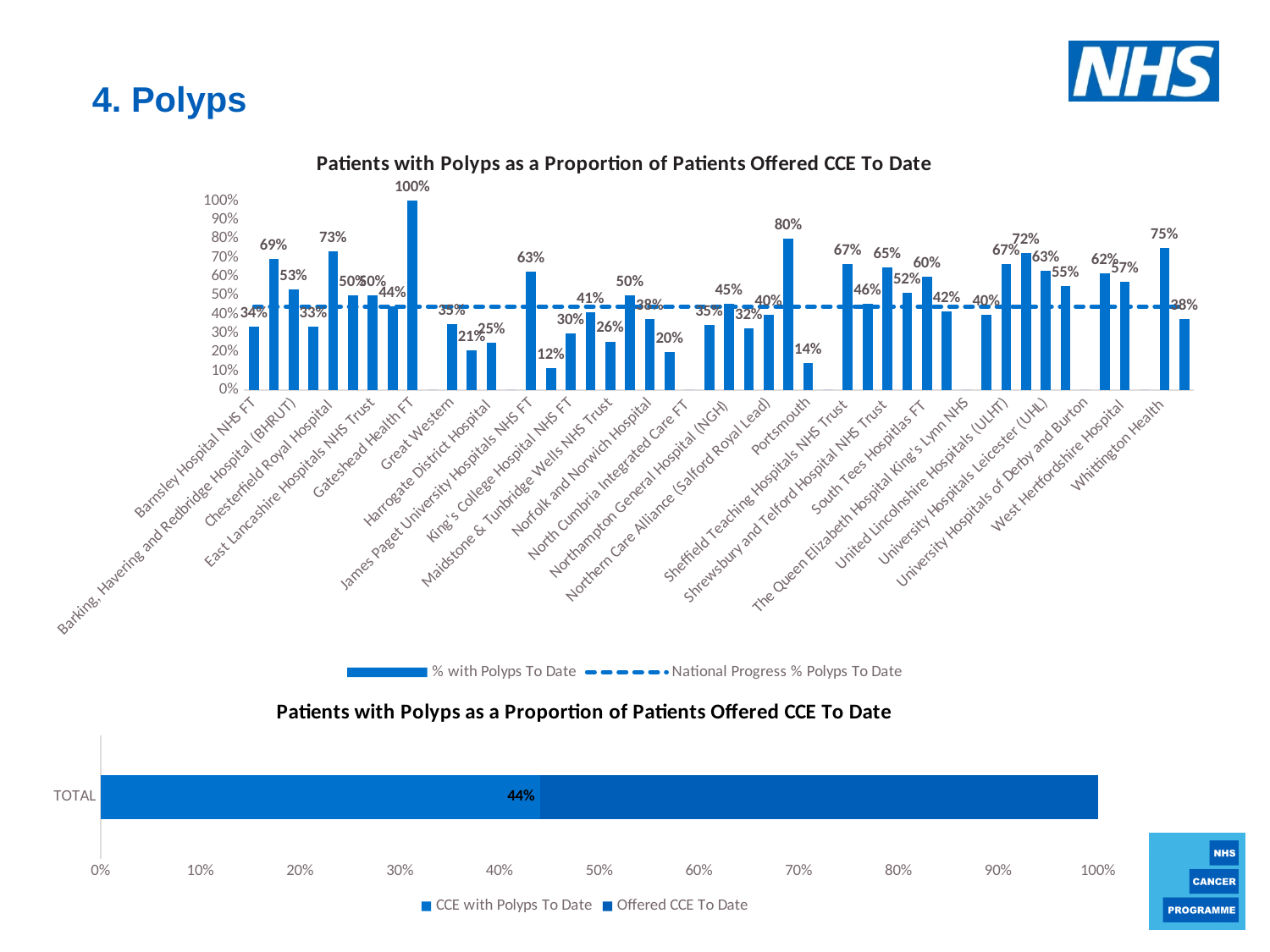
In the top chart, what is the lowest data label shown on any bar? 12% What kind of chart is the bottom chart? Bar chart In the bottom chart, what value is labelled on the TOTAL bar? 44% In the top chart, what is the difference between the value for Portsmouth and the value for Barnsley Hospital NHS FT? 20% In the top chart, what does the dashed horizontal line represent according to the legend? National Progress % Polyps To Date In the top chart, what is the value for Barnsley Hospital NHS FT? 34% In the top chart, what is the value for Chesterfield Royal Hospital? 73% In the top chart, which hospital has the highest proportion of patients with polyps? Gateshead Health FT In the top chart, what is the value for Portsmouth? 14% In the top chart, which is larger: the value for Gateshead Health FT or the value for Barnsley Hospital NHS FT? Gateshead Health FT In the top chart, how many series does the legend list? 2 In the top chart, what is the highest value shown by any bar? 100%